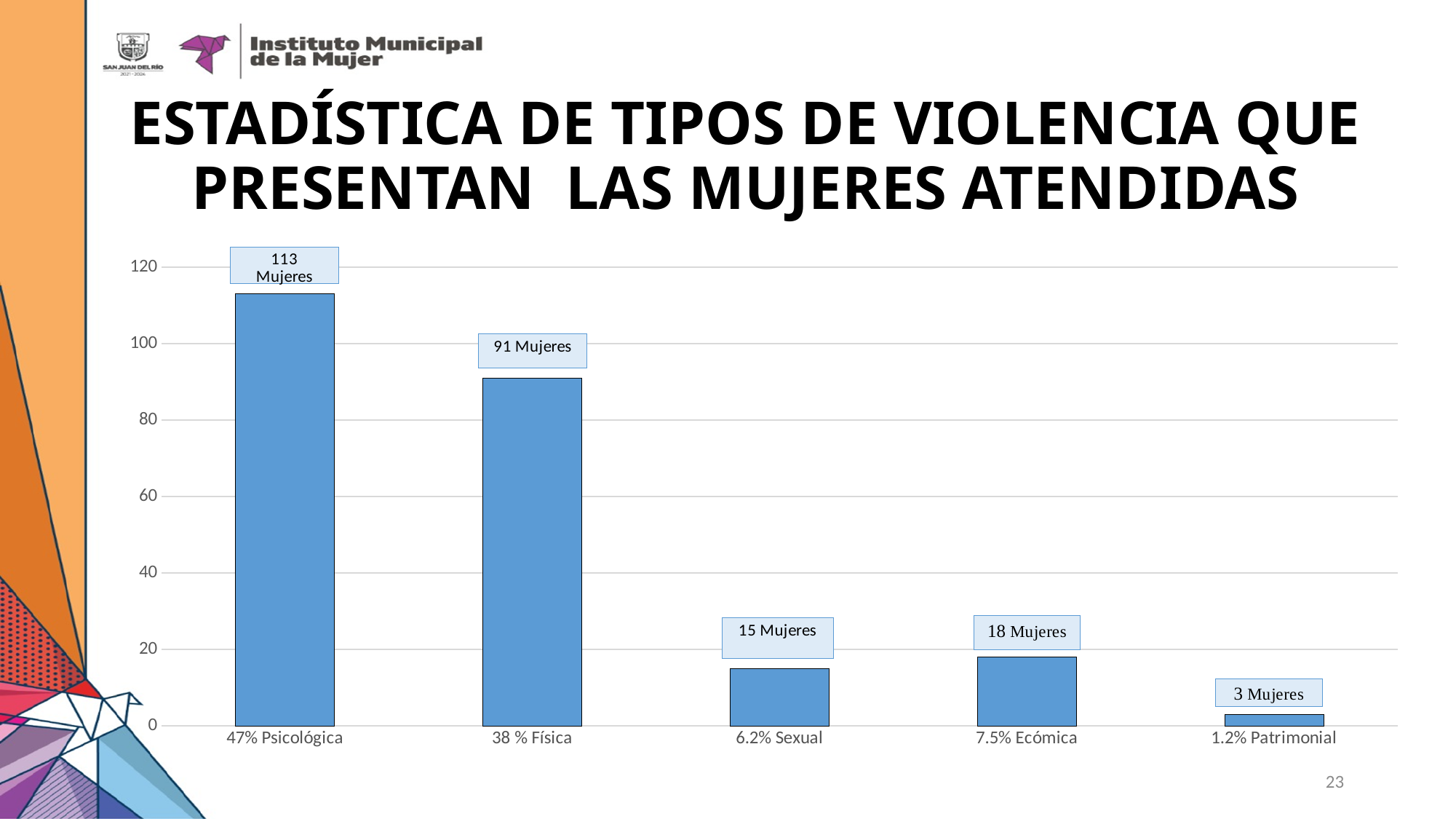
What is the data label on the bar for '1.2% Patrimonial'? 3 Mujeres Which category has the highest bar? 47% Psicológica Is the value for '38 % Física' greater or less than 100? less What kind of chart is shown on the slide? Bar chart Which category has the lowest bar? 1.2% Patrimonial How many women are shown for the '47% Psicológica' category? 113 Mujeres How many women are shown for the '6.2% Sexual' category? 15 Mujeres What is the difference in number of women between '47% Psicológica' and '38 % Física'? 22 What is the data label on the bar for '38 % Física'? 91 Mujeres How many categories are shown on the x axis? 5 What is the difference in number of women between '7.5% Ecómica' and '6.2% Sexual'? 3 Which has more women, '7.5% Ecómica' or '6.2% Sexual'? 7.5% Ecómica